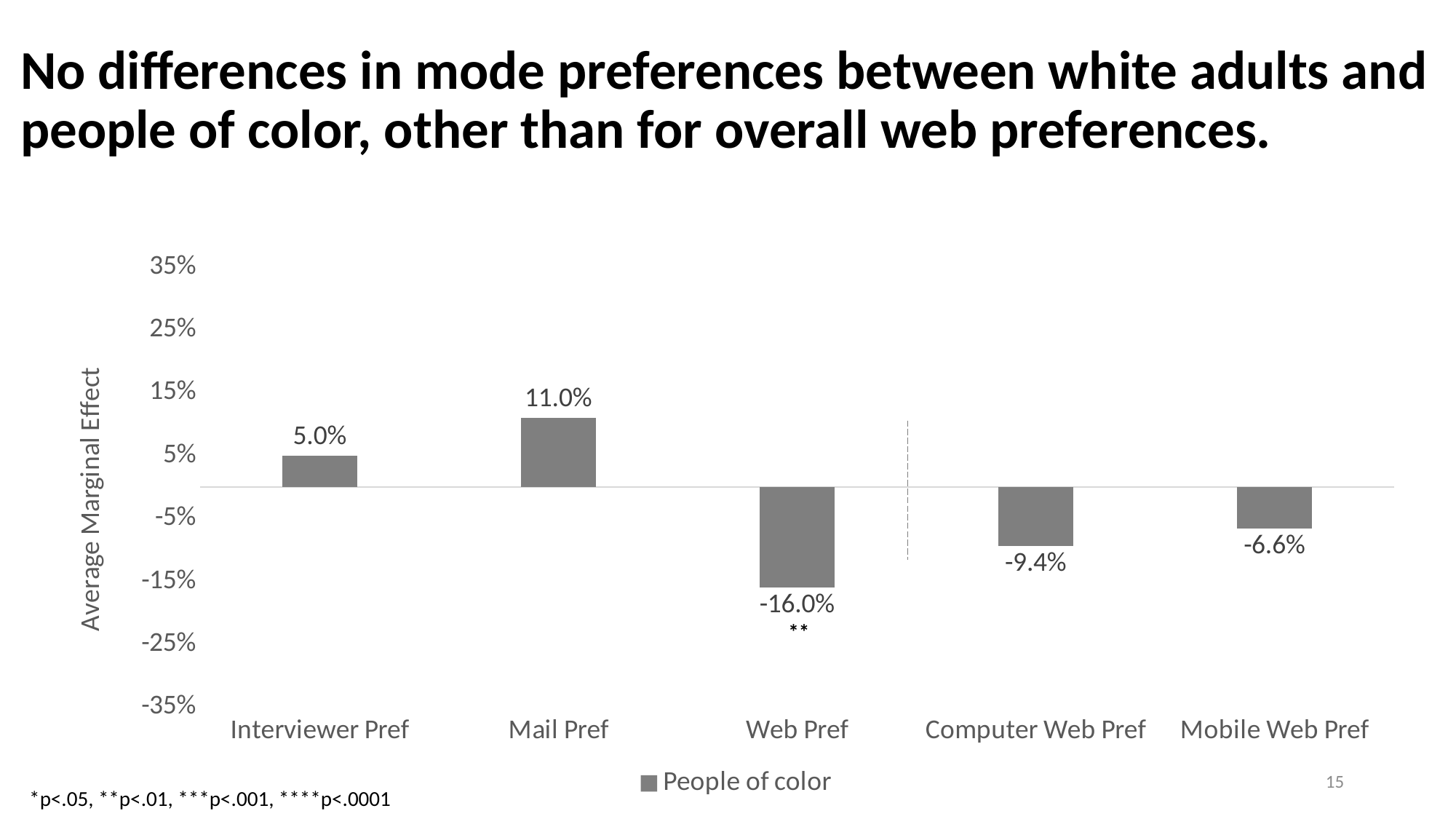
What is the value shown for Interviewer Pref? 5.0% What kind of chart is shown on the slide? Bar chart What is the value shown for Computer Web Pref? -9.4% How many series does the legend list? 1 Which is larger, the value for Computer Web Pref or the value for Mobile Web Pref? Mobile Web Pref How many categories are shown on the x axis? 5 Which category has the lowest average marginal effect? Web Pref What is the difference between the values for Mail Pref and Interviewer Pref? 6.0% What is the label of the y axis? Average Marginal Effect What is the average marginal effect for Web Pref? -16.0% What is the average marginal effect for Mail Pref? 11.0% Which category has the highest average marginal effect? Mail Pref